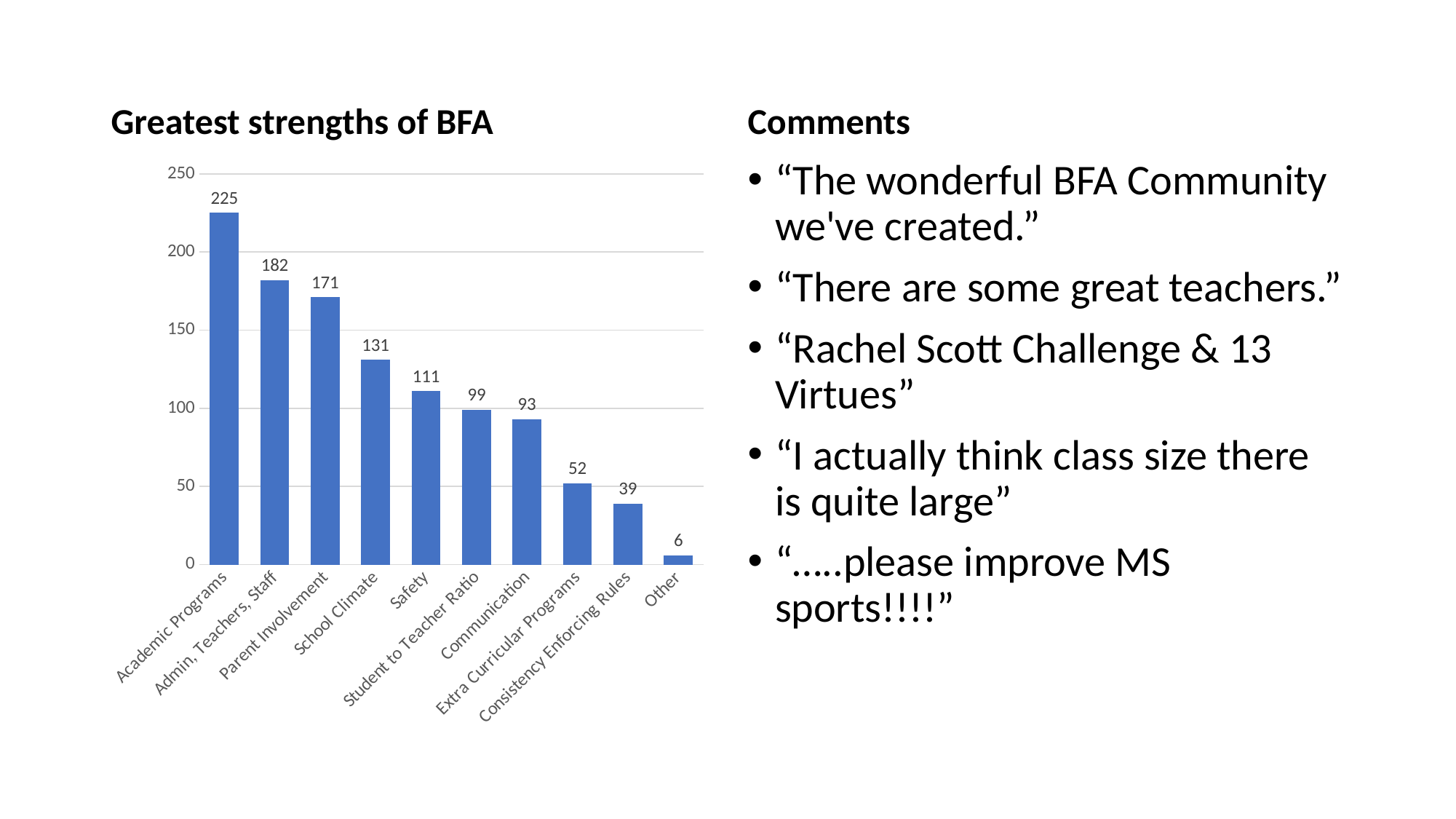
Which category has the highest value? Academic Programs Which category has the lowest value? Other What is the value for Consistency Enforcing Rules? 39 What is the value for School Climate? 131 What is the title of the chart? Greatest strengths of BFA Which is larger, the value for Safety or the value for Communication? Safety Do the values rise or fall from left to right along the x axis? fall How many categories are shown in the chart? 10 Is the value for Student to Teacher Ratio greater or less than 100? less What is the value for Academic Programs? 225 What is the difference between the values for Admin, Teachers, Staff and Parent Involvement? 11 What kind of chart is shown on the slide? bar chart